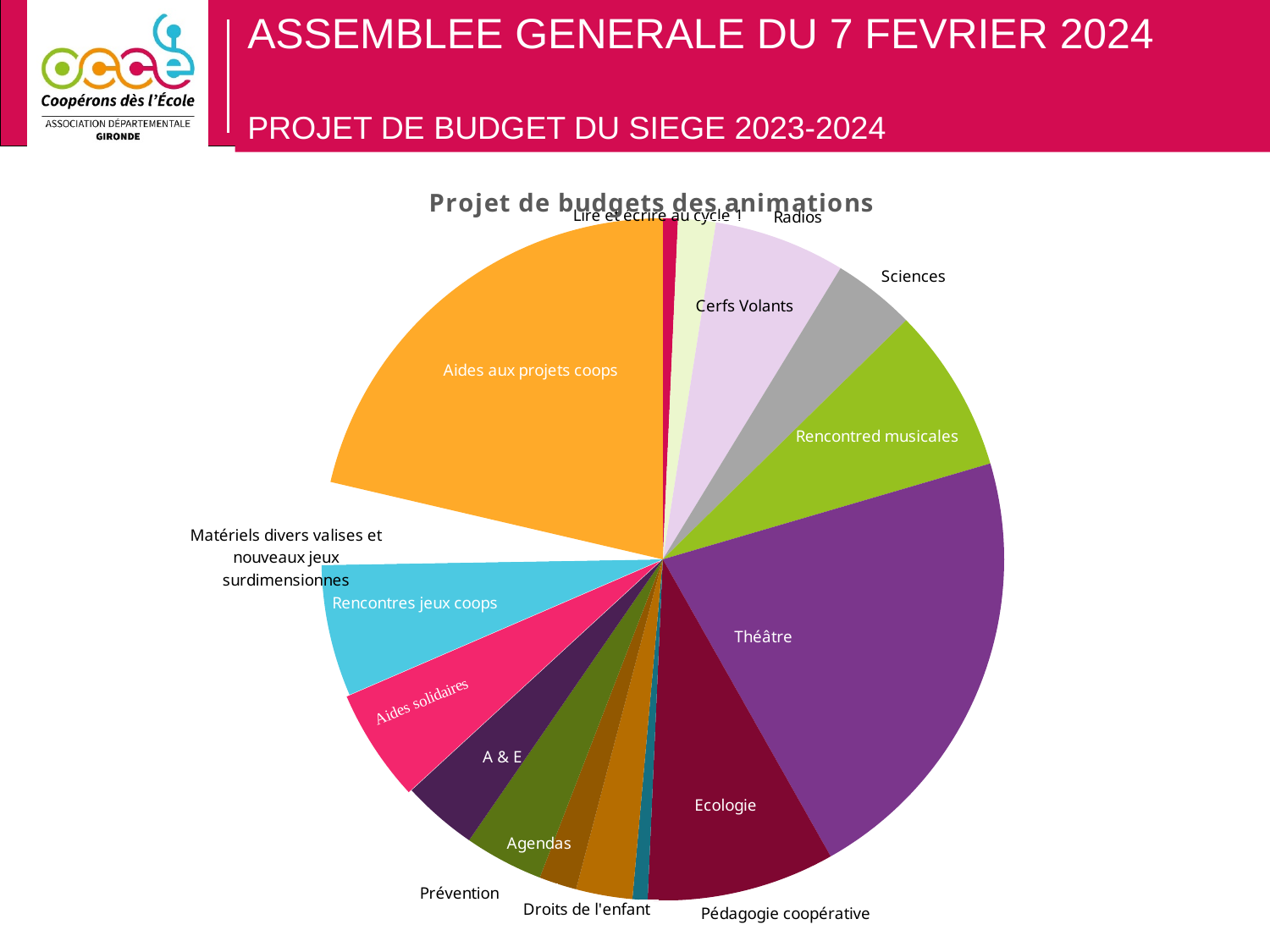
Which slice is larger, Ecologie or Cerfs Volants? Ecologie Which slice is larger, Théâtre or Sciences? Théâtre What is the title of the chart? Projet de budgets des animations Which slice is larger, Aides solidaires or Droits de l'enfant? Aides solidaires What kind of chart is shown on the slide? pie chart Which slice is pulled out (exploded) from the rest of the pie? Aides aux projets coops